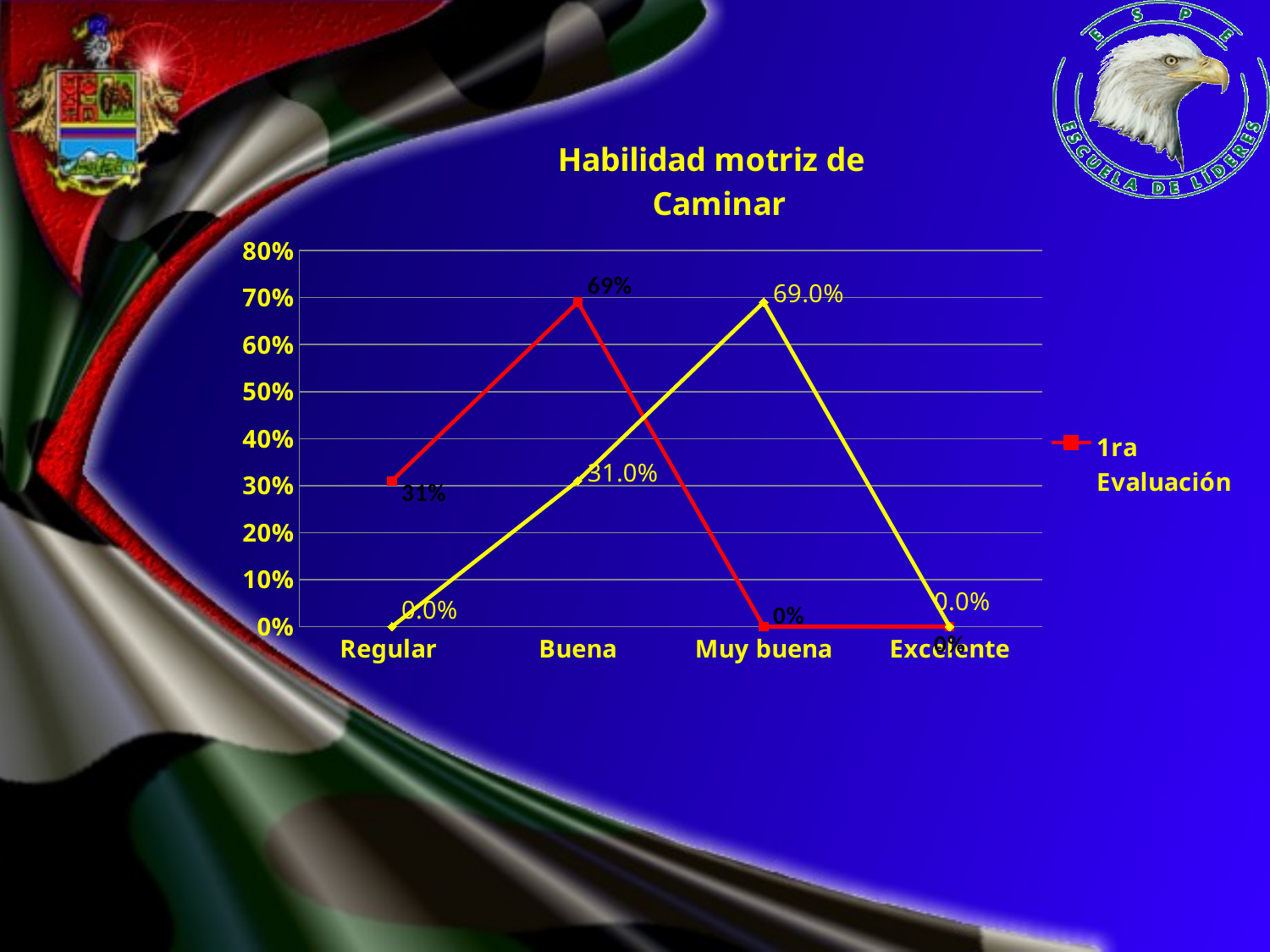
What is the value of the yellow line for Buena? 31.0% What type of chart is shown on the slide? line chart For Muy buena, which is larger: the 1ra Evaluación value or the yellow line value? the yellow line Which category has the highest value for the 1ra Evaluación series? Buena What is the title of the chart? Habilidad motriz de Caminar How many categories are shown on the x axis of the chart? 4 Which category has the highest value for the yellow line? Muy buena What is the value of the 1ra Evaluación series for Regular? 31% How many series does the chart legend list? 1 What is the value of the 1ra Evaluación series for Buena? 69% What is the difference between the 1ra Evaluación values for Buena and Regular? 38% What is the value of the yellow line for Muy buena? 69.0%